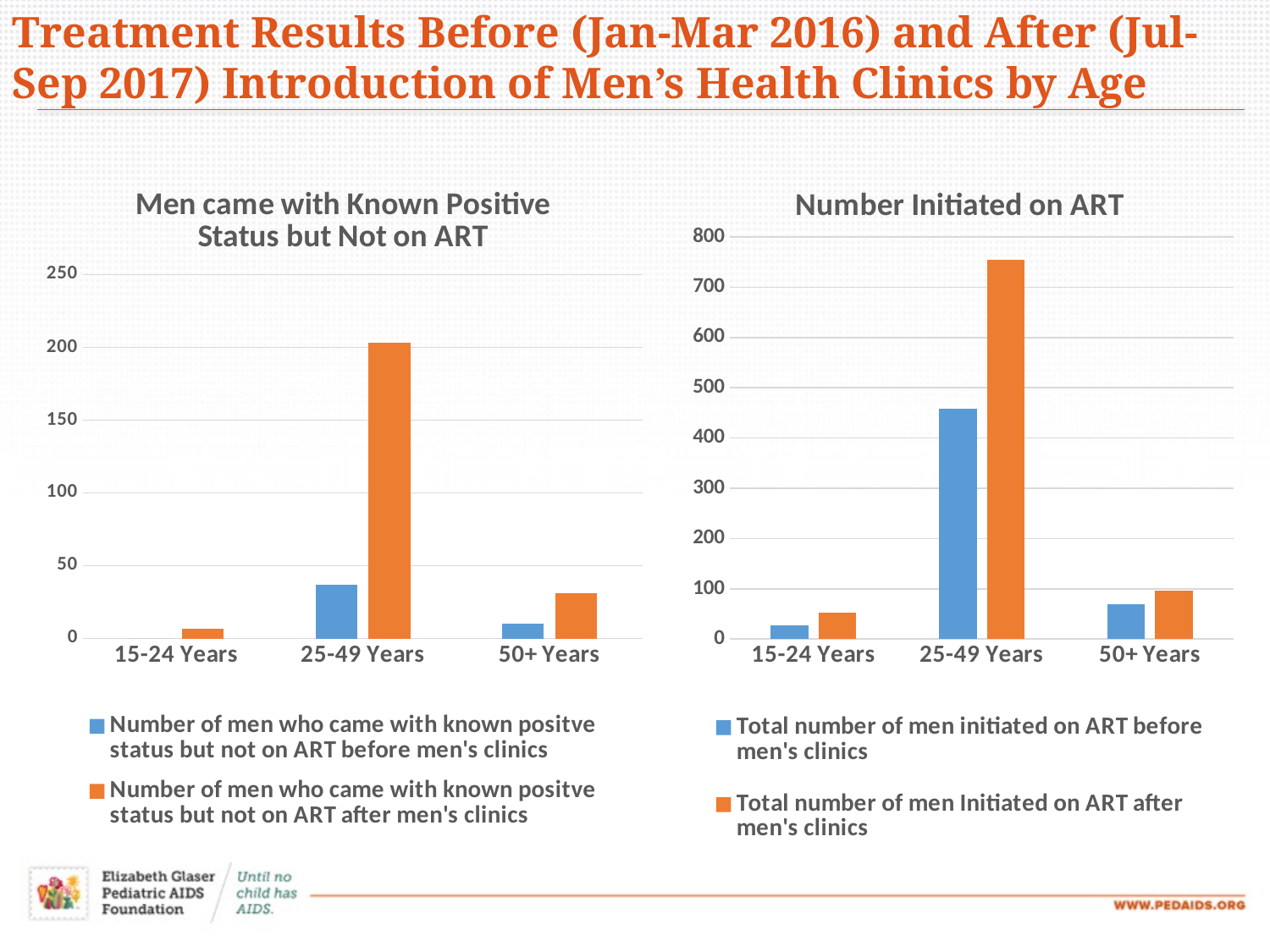
In the chart titled "Number Initiated on ART", is the value for men initiated on ART before men's clinics in the 25-49 Years group greater or less than 500? less In the chart titled "Number Initiated on ART", for the 50+ Years group, which is larger: the number initiated before men's clinics or after men's clinics? after men's clinics What type of chart is the chart titled "Number Initiated on ART"? bar chart In the chart titled "Number Initiated on ART", which age group has the tallest bar for men initiated on ART after men's clinics? 25-49 Years How many age groups are shown on the x axis of the chart titled "Number Initiated on ART"? 3 In the chart titled "Men came with Known Positive Status but Not on ART", is the value for the 25-49 Years group after men's clinics greater or less than 150? greater In the chart titled "Men came with Known Positive Status but Not on ART", which age group has the highest value for men who came with known positive status but not on ART after men's clinics? 25-49 Years In the chart titled "Number Initiated on ART", which age group has the lowest number of men initiated on ART before men's clinics? 15-24 Years How many series does the legend of the chart titled "Men came with Known Positive Status but Not on ART" list? 2 In the chart titled "Number Initiated on ART", is the value for men initiated on ART after men's clinics in the 25-49 Years group greater or less than 700? greater In the chart titled "Men came with Known Positive Status but Not on ART", for the 25-49 Years group, which is larger: the value before men's clinics or after men's clinics? after men's clinics